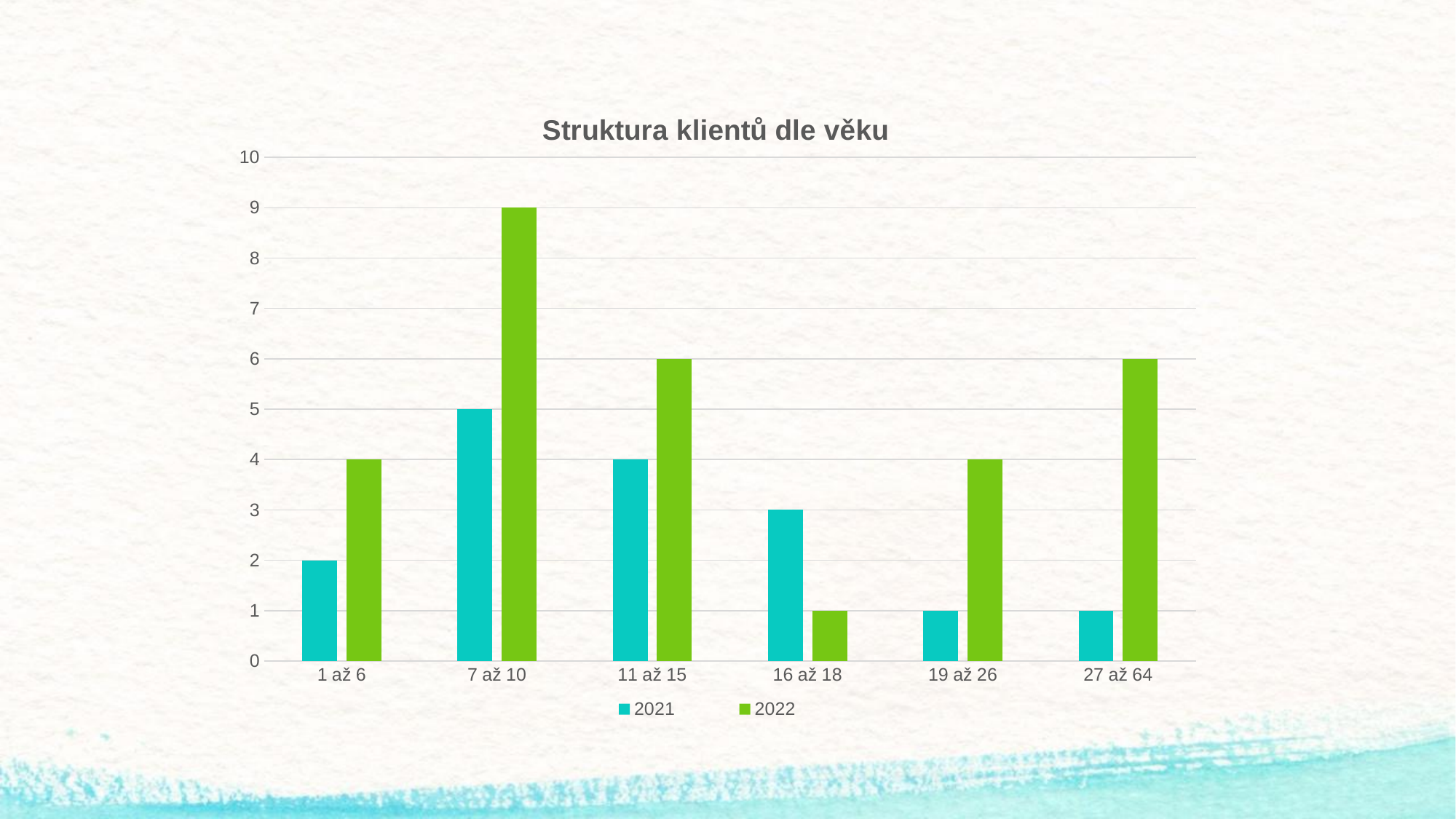
What is the value for 2021 in the 16 až 18 category? 3 How many age categories are shown on the x axis? 6 Which category has the highest value for the 2021 series? 7 až 10 What kind of chart is shown on the slide? bar chart What is the value for 2022 in the 7 až 10 category? 9 What is the title of the chart? Struktura klientů dle věku In the 16 až 18 category, which series has the larger value, 2021 or 2022? 2021 What is the difference between the 2022 and 2021 values in the 27 až 64 category? 5 Is the value for 2022 in the 11 až 15 category greater or less than 5? greater How many series does the legend list? 2 Which category has the lowest value for the 2022 series? 16 až 18 What is the value for 2022 in the 19 až 26 category? 4